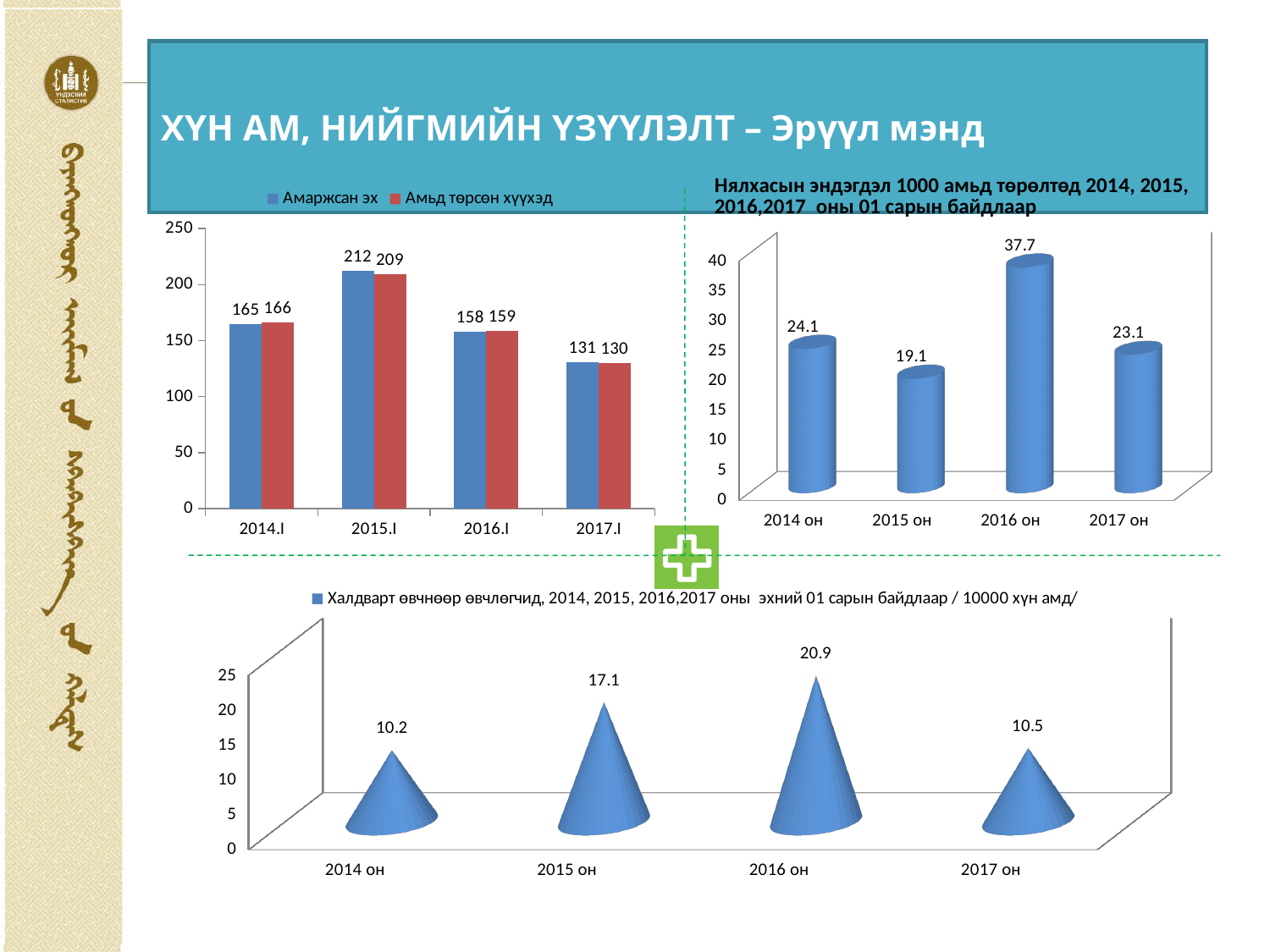
In the top-right chart (Нялхасын эндэгдэл 1000 амьд төрөлтөд), what is the value for 2016 он? 37.7 In the top-left chart, what is the value for Амьд төрсөн хүүхэд in 2017.I? 130 In the top-right chart (Нялхасын эндэгдэл 1000 амьд төрөлтөд), which year has the lowest value? 2015 он In the top-left chart, what is the value for Амаржсан эх in 2015.I? 212 How many categories are shown on the x axis of the bottom chart (Халдварт өвчнөөр өвчлөгчид)? 4 In the bottom chart (Халдварт өвчнөөр өвчлөгчид), what is the value for 2015 он? 17.1 In the top-left chart, which period has the lowest value for Амаржсан эх? 2017.I In the bottom chart (Халдварт өвчнөөр өвчлөгчид), which year has the highest value? 2016 он In the bottom chart (Халдварт өвчнөөр өвчлөгчид), which is larger: the value for 2014 он or 2017 он? 2017 он In the top-right chart (Нялхасын эндэгдэл 1000 амьд төрөлтөд), what is the difference between 2016 он and 2017 он? 14.6 In the top-left chart, how many series does the legend list? 2 In the top-left chart, what is the difference between Амаржсан эх and Амьд төрсөн хүүхэд in 2015.I? 3